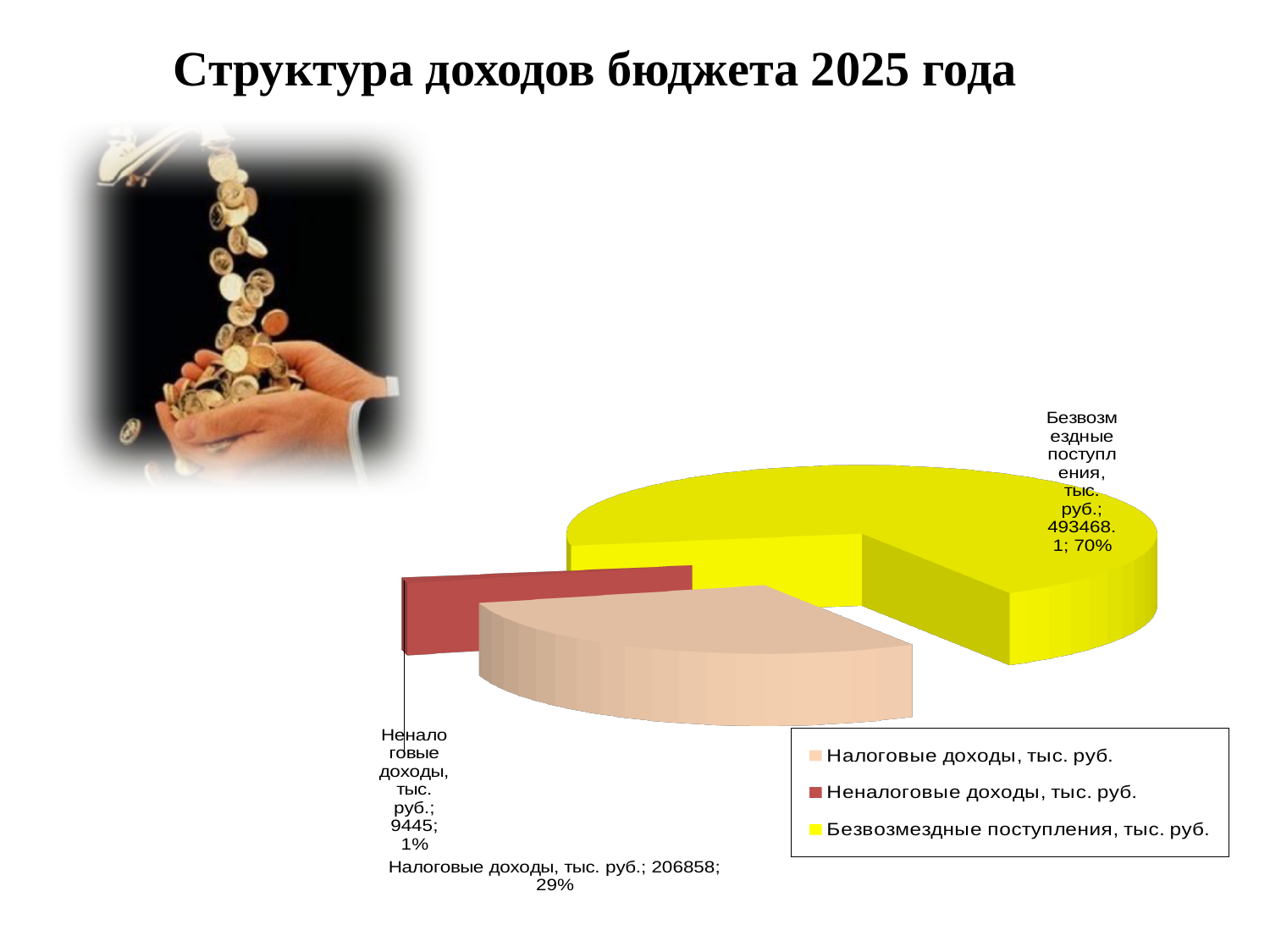
What kind of chart is shown on the slide? Pie chart How many categories does the pie chart have? 3 Which is larger, Налоговые доходы or Неналоговые доходы? Налоговые доходы Which category has the smallest slice of the pie? Неналоговые доходы, тыс. руб. What share of the pie does Безвозмездные поступления take? 70% What is the value for Налоговые доходы, тыс. руб.? 206858 What is the value for Неналоговые доходы, тыс. руб.? 9445 Which category has the largest slice of the pie? Безвозмездные поступления, тыс. руб. What share of the pie does Неналоговые доходы take? 1% What share of the pie does Налоговые доходы take? 29% What is the value for Безвозмездные поступления, тыс. руб.? 493468.1 What is the title of the slide? Структура доходов бюджета 2025 года